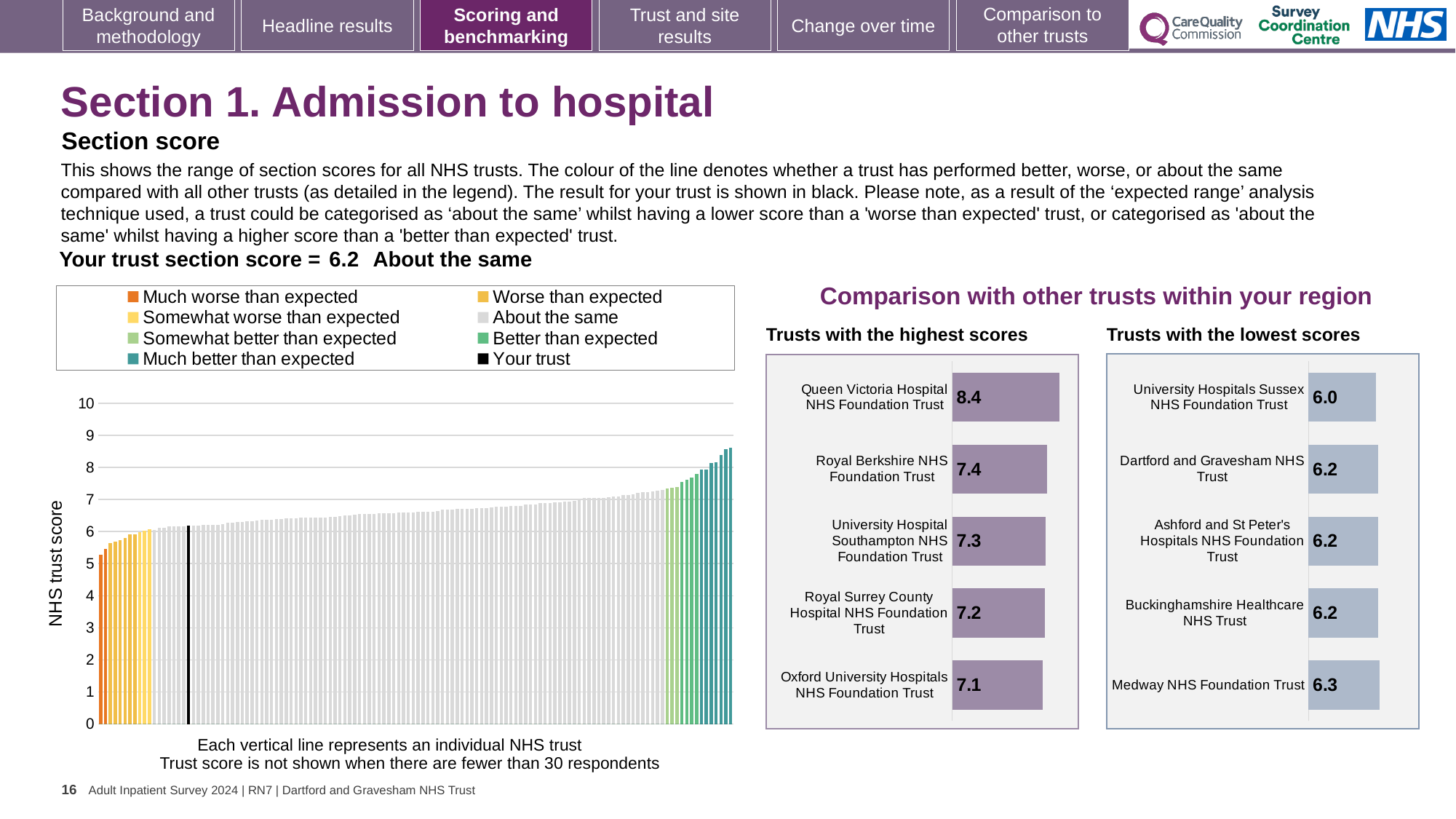
How many entries does the legend of the large chart on the left list? 8 In the 'Trusts with the lowest scores' chart, which trust has the lowest score? University Hospitals Sussex NHS Foundation Trust In the large chart on the left, is the value for the black 'Your trust' bar greater or less than 7? less In the 'Trusts with the lowest scores' chart, which is larger: the score for Medway NHS Foundation Trust or University Hospitals Sussex NHS Foundation Trust? Medway NHS Foundation Trust In the 'Trusts with the highest scores' chart, what is the score for Queen Victoria Hospital NHS Foundation Trust? 8.4 In the large chart on the left, do the NHS trust scores rise or fall from left to right? Rise In the 'Trusts with the highest scores' chart, how many trusts are listed? 5 In the 'Trusts with the lowest scores' chart, what is the score for Dartford and Gravesham NHS Trust? 6.2 In the 'Trusts with the highest scores' chart, what is the difference between the scores of Queen Victoria Hospital NHS Foundation Trust and Royal Berkshire NHS Foundation Trust? 1.0 In the 'Trusts with the highest scores' chart, which trust has the lowest score shown? Oxford University Hospitals NHS Foundation Trust What kind of chart is the large chart on the left showing NHS trust scores? Bar chart In the 'Trusts with the lowest scores' chart, what is the score for Medway NHS Foundation Trust? 6.3